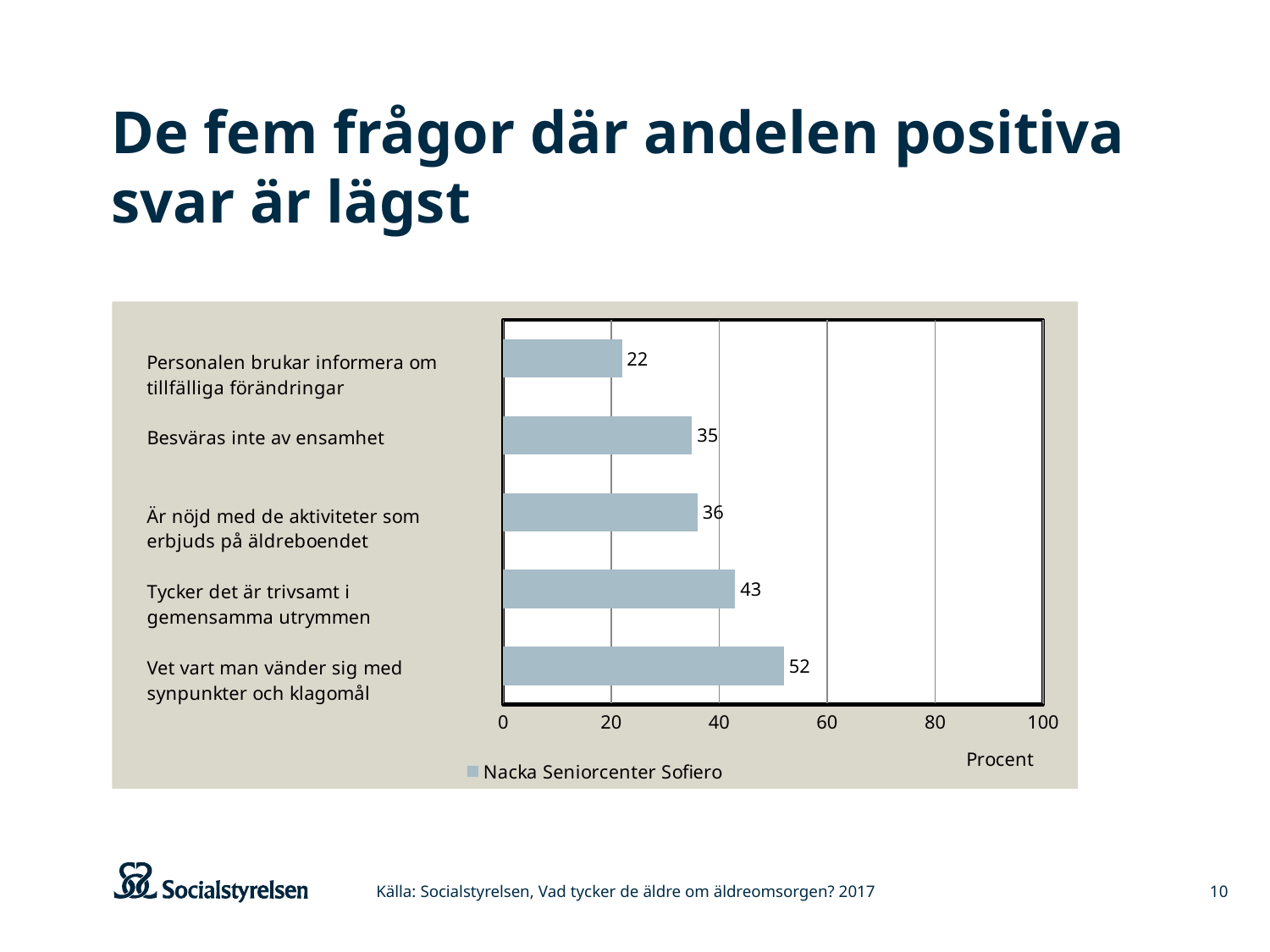
Which is larger: the value for "Tycker det är trivsamt i gemensamma utrymmen" or the value for "Besväras inte av ensamhet"? Tycker det är trivsamt i gemensamma utrymmen What is the difference between the values for "Vet vart man vänder sig med synpunkter och klagomål" and "Tycker det är trivsamt i gemensamma utrymmen"? 9 What kind of chart is shown on the slide? bar chart How many categories are shown in the chart? 5 Which category has the lowest value? Personalen brukar informera om tillfälliga förändringar Which category has the highest value? Vet vart man vänder sig med synpunkter och klagomål What is the value for "Vet vart man vänder sig med synpunkter och klagomål"? 52 How many series does the legend list? 1 What is the value for "Besväras inte av ensamhet"? 35 What is the name of the series shown in the legend? Nacka Seniorcenter Sofiero Is the value for "Är nöjd med de aktiviteter som erbjuds på äldreboendet" greater or less than 40? less What is the value for "Personalen brukar informera om tillfälliga förändringar"? 22